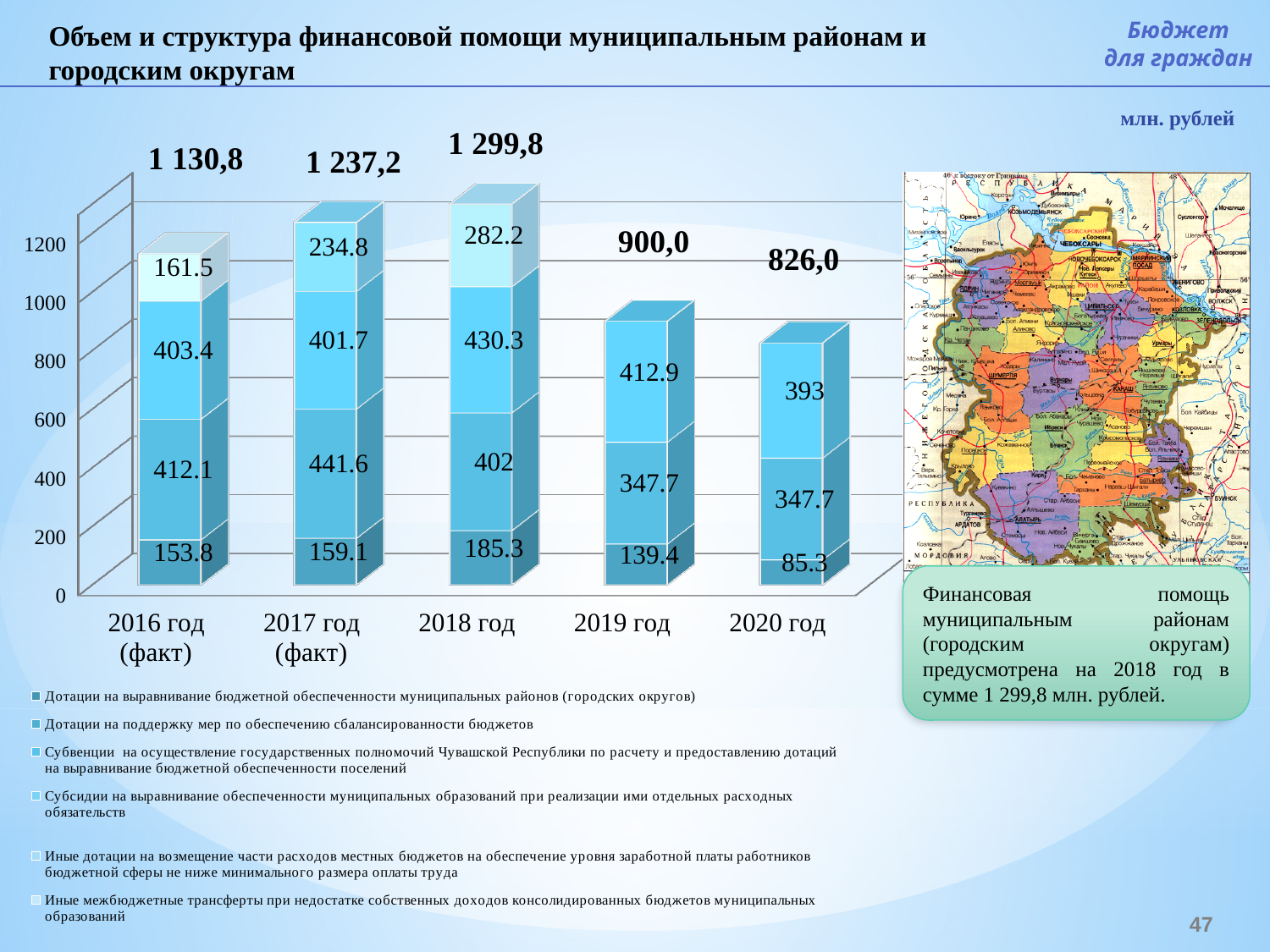
What is the value of the top segment of the 2018 год bar? 282.2 Which year has the highest total financial assistance? 2018 год In what units are the values on the chart expressed? млн. рублей Which total is larger, 2016 год (факт) or 2017 год (факт)? 2017 год (факт) Which year has the lowest total financial assistance? 2020 год How many years (categories) are shown on the x axis? 5 What is the value of the bottom segment of the 2020 год bar? 85.3 What is the total shown above the bar for 2020 год? 826,0 How many series does the legend list? 6 What is the difference between the totals for 2018 год and 2019 год? 399,8 What is the total financial assistance shown above the bar for 2018 год? 1 299,8 What kind of chart is shown on the slide? stacked bar chart